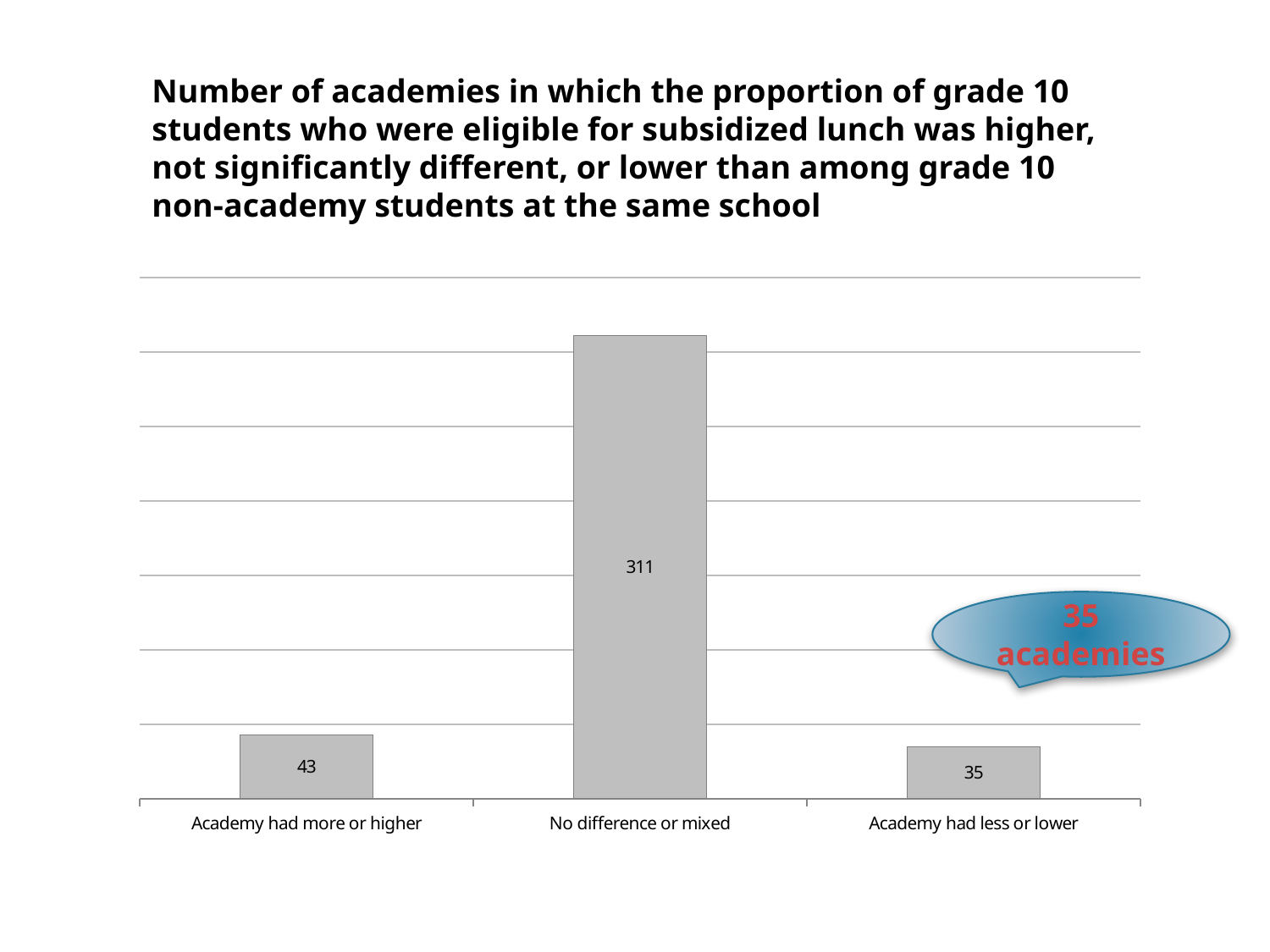
What is the value for 'Academy had less or lower'? 35 Which category has the lowest value? Academy had less or lower What is the value for 'No difference or mixed'? 311 What is the difference between the values for 'No difference or mixed' and 'Academy had more or higher'? 268 What is the total of the three values shown in the chart? 389 What kind of chart is shown on the slide? Bar chart Which category has the highest value? No difference or mixed What does the callout bubble on the chart say? 35 academies What is the value for 'Academy had more or higher'? 43 How many categories are shown on the x axis? 3 Which is larger, the value for 'Academy had more or higher' or the value for 'Academy had less or lower'? Academy had more or higher What is the difference between the values for 'Academy had more or higher' and 'Academy had less or lower'? 8